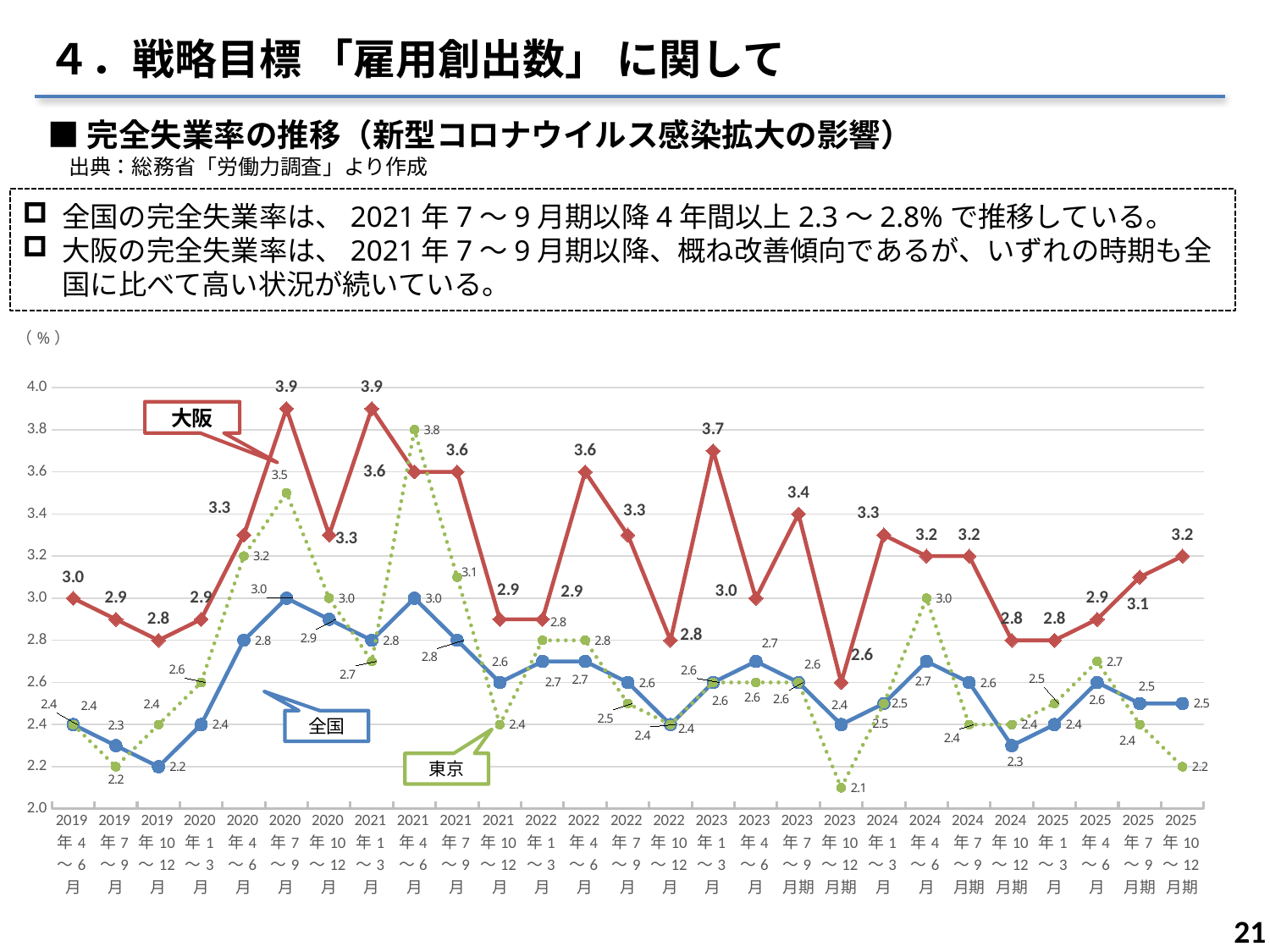
What is the value for 大阪 in 2025年10〜12月期? 3.2 What kind of chart is shown on the slide? line chart What is the value for 大阪 in 2021年1〜3月? 3.9 In 2021年4〜6月, which is higher, 東京 or 大阪? 東京 What is the value for 全国 in 2020年7〜9月? 3.0 How many periods are plotted along the x axis? 27 How many series are plotted in the chart? 3 What is the value for 東京 in 2021年4〜6月? 3.8 What is the difference between 大阪 and 全国 in 2023年10〜12月期? 0.2 In which period does 東京 reach its lowest value? 2023年10〜12月期 In which period does 東京 reach its highest value? 2021年4〜6月 In which period does 全国 reach its lowest value? 2019年10〜12月